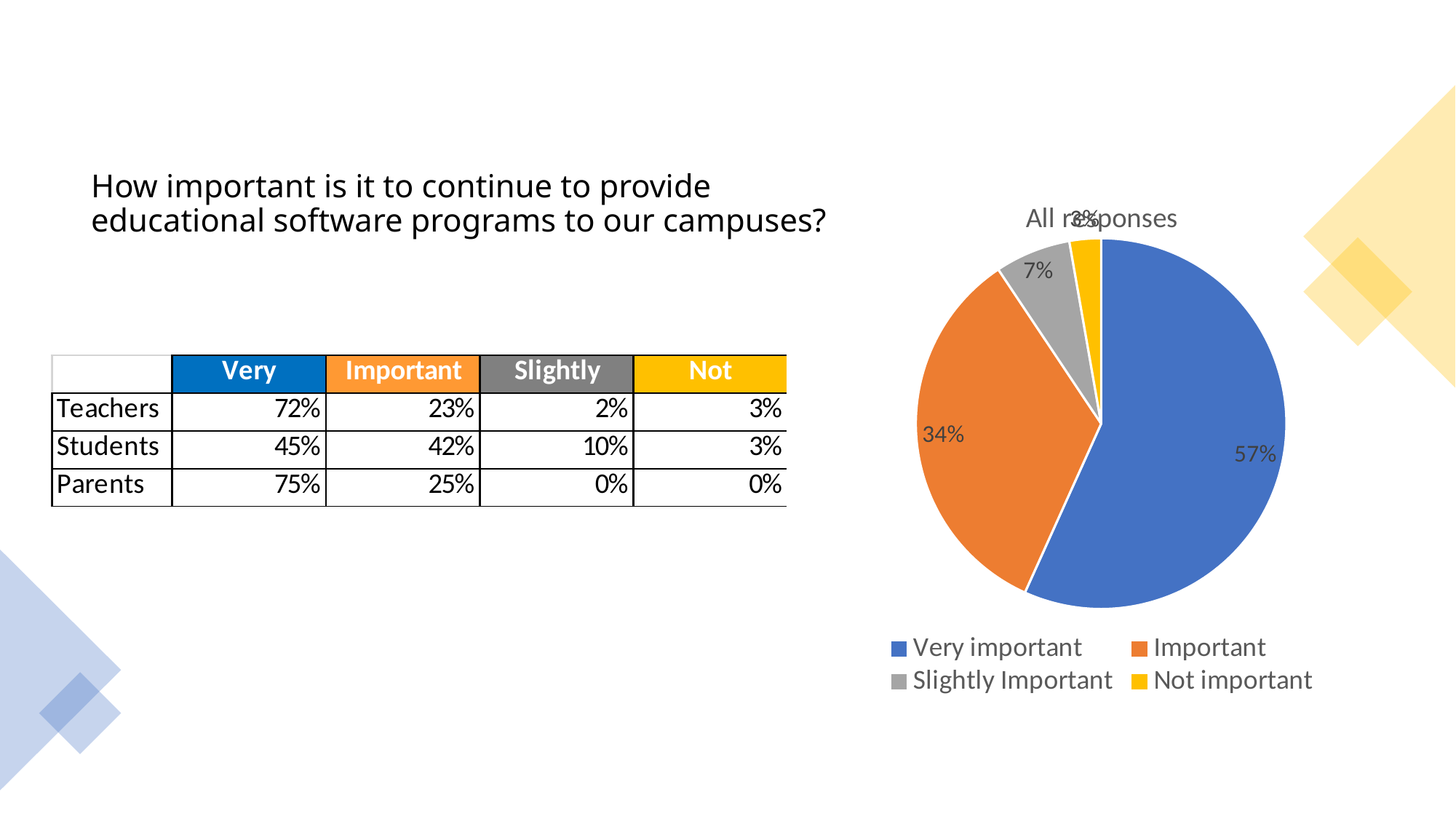
In the pie chart, what is the difference between the 'Important' and 'Slightly Important' shares? 27% In the pie chart, what percentage of responses are 'Slightly Important'? 7% In the pie chart, how many percentage points larger is 'Very important' than 'Important'? 23% What kind of chart is shown on the slide? pie chart What is the title of the pie chart? All responses Which category has the largest slice in the pie chart? Very important How many categories does the pie chart's legend list? 4 In the pie chart, which is larger: 'Important' or 'Slightly Important'? Important In the pie chart, what percentage of responses are 'Very important'? 57% Which category has the smallest slice in the pie chart? Not important In the pie chart, what percentage of responses are 'Important'? 34% What colour is the 'Very important' slice in the pie chart? blue